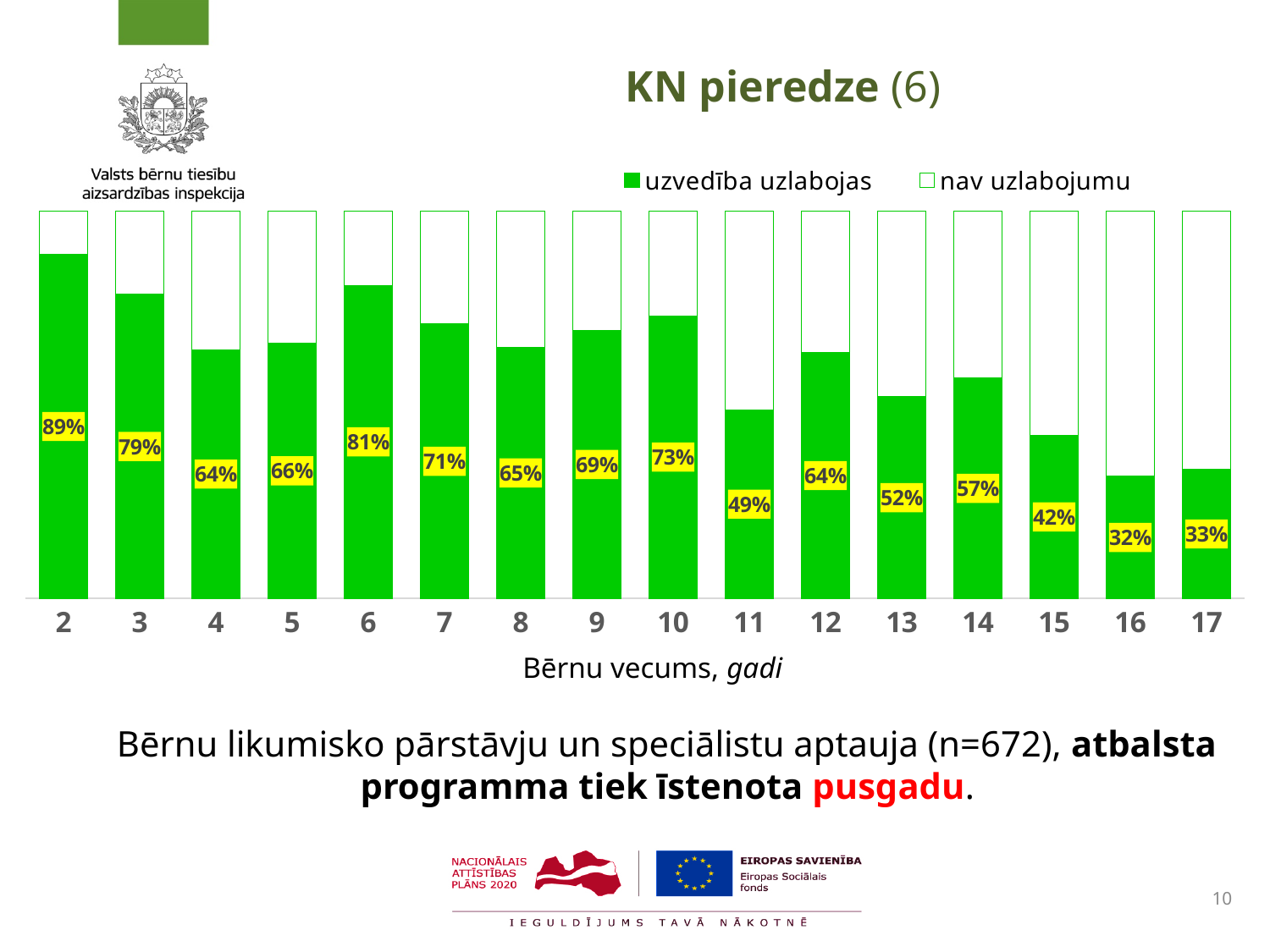
How many series does the legend list? 2 What percentage of children aged 2 show improved behaviour (uzvedība uzlabojas)? 89% What is the 'uzvedība uzlabojas' value for children aged 15? 42% Which age has the lowest 'uzvedība uzlabojas' percentage? 16 What is the label of the x axis? Bērnu vecums, gadi What is the difference in percentage points between the 'uzvedība uzlabojas' values for age 2 and age 16? 57 percentage points Which has a higher 'uzvedība uzlabojas' value, age 6 or age 10? age 6 How many age categories are shown on the x axis? 16 What is the 'uzvedība uzlabojas' value for children aged 11? 49% What kind of chart is shown on the slide? stacked bar chart Overall, does the 'uzvedība uzlabojas' percentage rise or fall as the children's age increases from 2 to 17? fall Which age has the highest 'uzvedība uzlabojas' percentage? 2